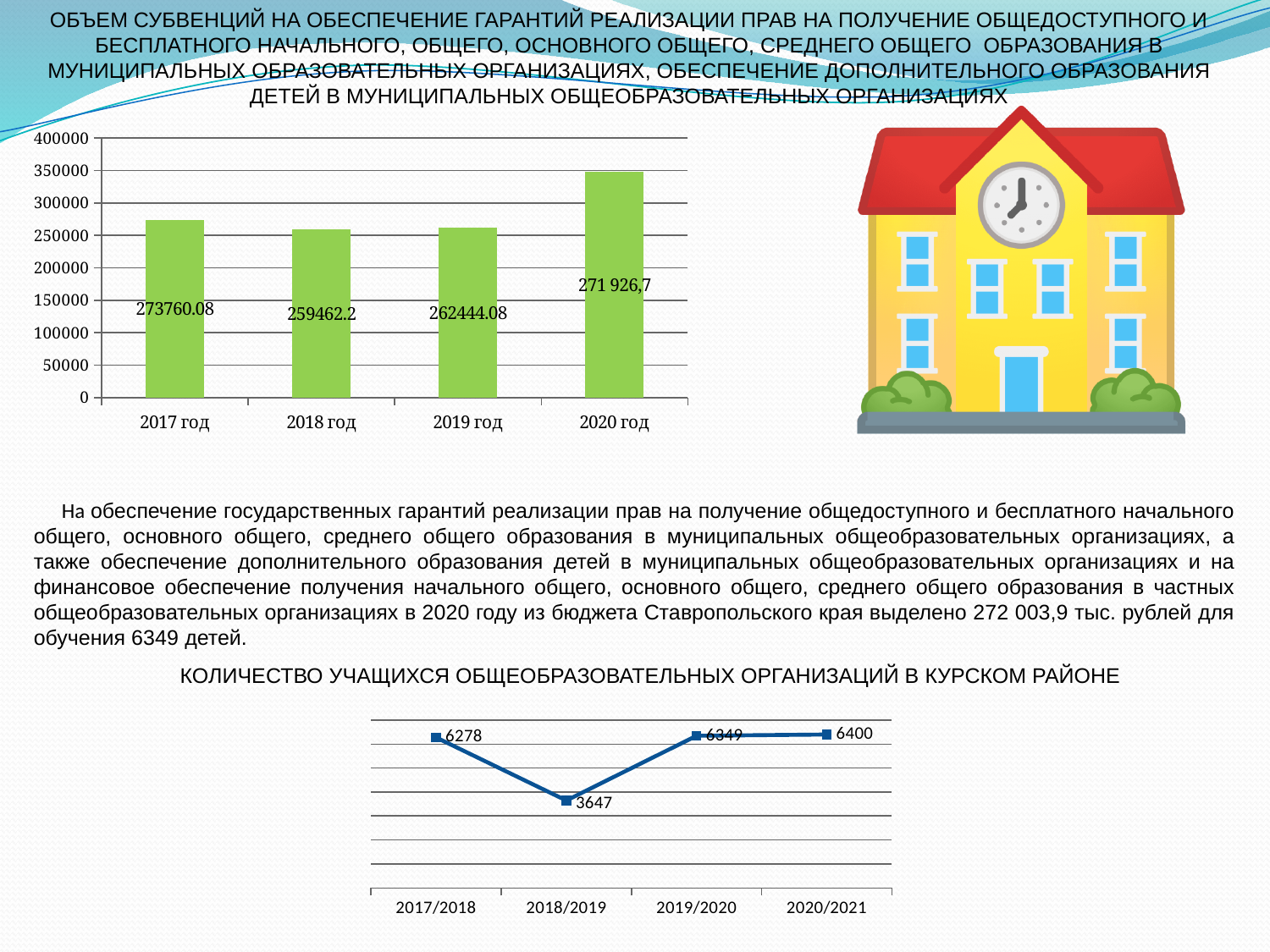
In the top bar chart, what is the data label shown for 2020 год? 271 926,7 In the bottom line chart, which period has the highest value? 2020/2021 In the top bar chart, what is the value for 2018 год? 259462.2 What type of chart is the chart at the top of the slide? bar chart What type of chart is the chart at the bottom of the slide? line chart In the bottom line chart 'Количество учащихся общеобразовательных организаций в Курском районе', what is the value for 2018/2019? 3647 In the bottom line chart, what is the difference between the values for 2020/2021 and 2019/2020? 51 How many bars are in the top bar chart? 4 In the top bar chart, what is the value for 2017 год? 273760.08 In the top bar chart, which year has the lowest value? 2018 год In the top bar chart, is the value for 2019 год greater or less than 300000? less In the top bar chart, which is larger, the value for 2017 год or 2018 год? 2017 год